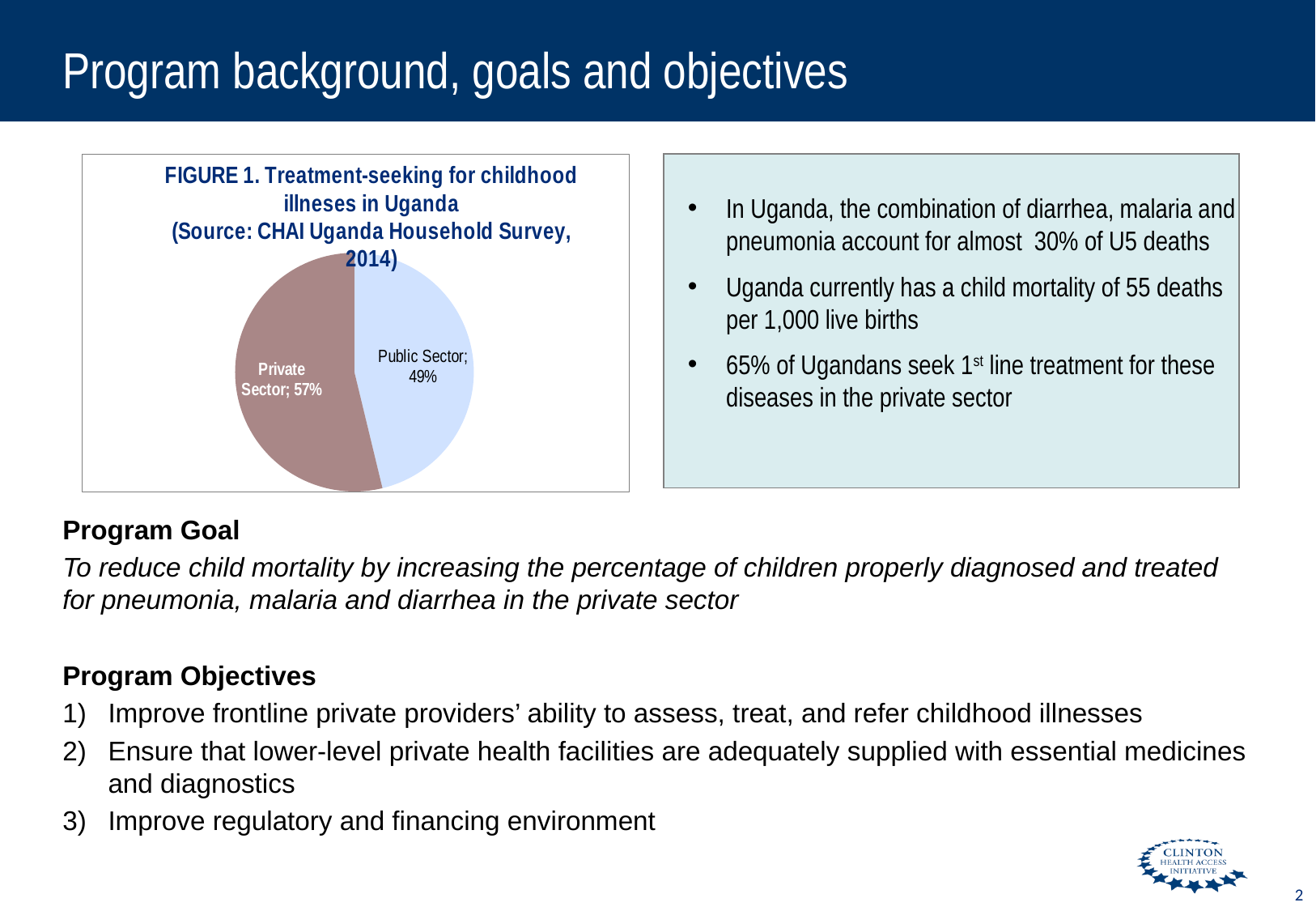
How many slices does the pie chart have? 2 Which sector has the smaller slice of the pie? Public Sector What is the title of the chart? FIGURE 1. Treatment-seeking for childhood illneses in Uganda (Source: CHAI Uganda Household Survey, 2014) What is the difference between the Private Sector and Public Sector percentages? 8 percentage points Is the Private Sector slice larger or smaller than the Public Sector slice? Larger Which sector has the larger slice of the pie? Private Sector What kind of chart is Figure 1? Pie chart What is the source cited in the chart title? CHAI Uganda Household Survey, 2014 What percentage is shown for the Private Sector slice? 57% What percentage is shown for the Public Sector slice? 49% What share of the pie does the Public Sector slice represent? 49%